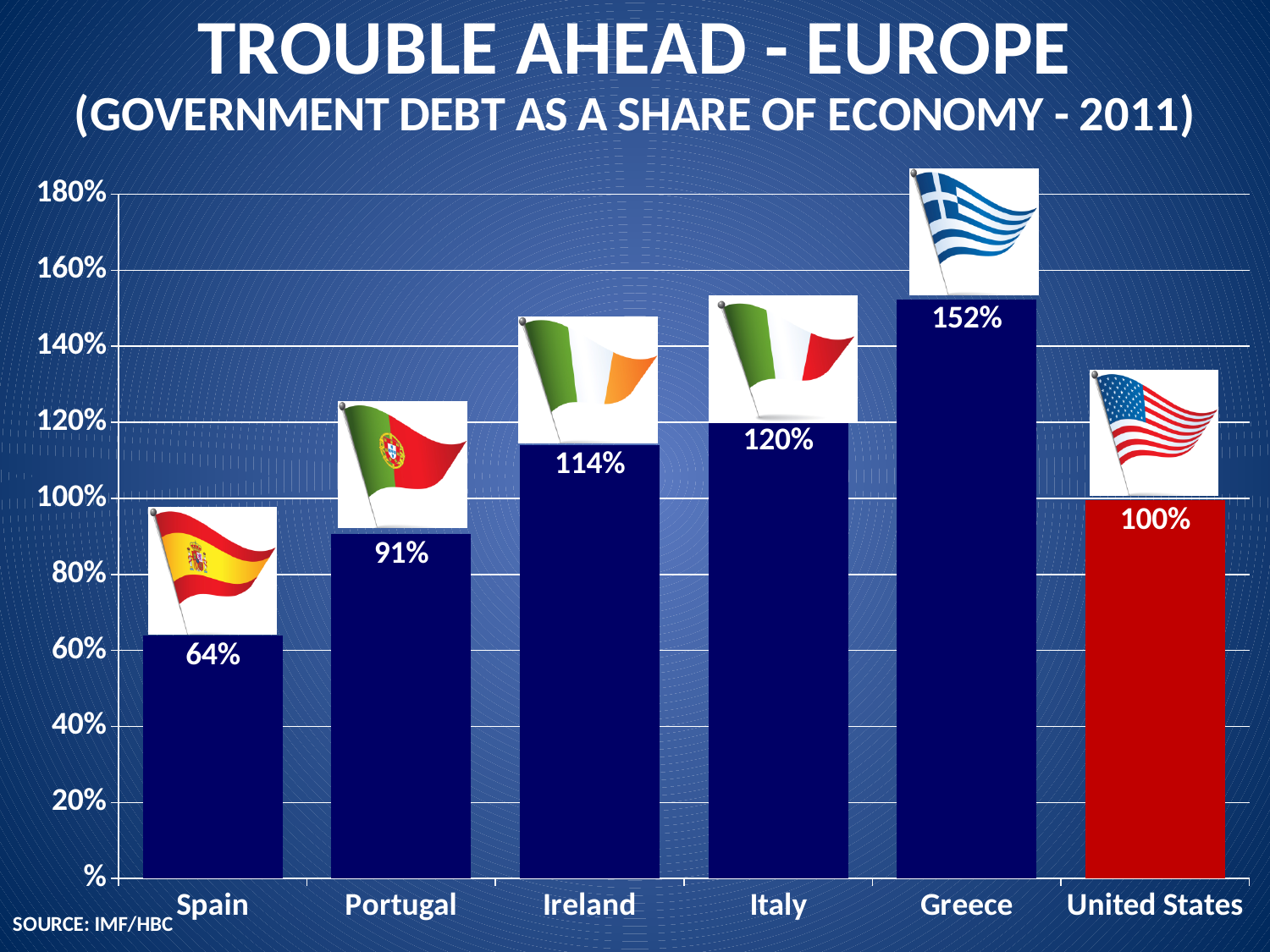
Which country has the lowest government debt as a share of economy? Spain Which is larger, the value for Italy or the value for Ireland? Italy What is the government debt as a share of economy for Greece? 152% How many countries are shown on the chart? 6 What is the value shown for Spain? 64% What is the difference between the values for Greece and the United States? 52% What is the difference between the values for Italy and Portugal? 29% What kind of chart is shown on the slide? bar chart Which country has the highest government debt as a share of economy? Greece Is the value for Portugal greater or less than 100%? less What is the value shown for Ireland? 114% Which bar is coloured red rather than dark blue? United States